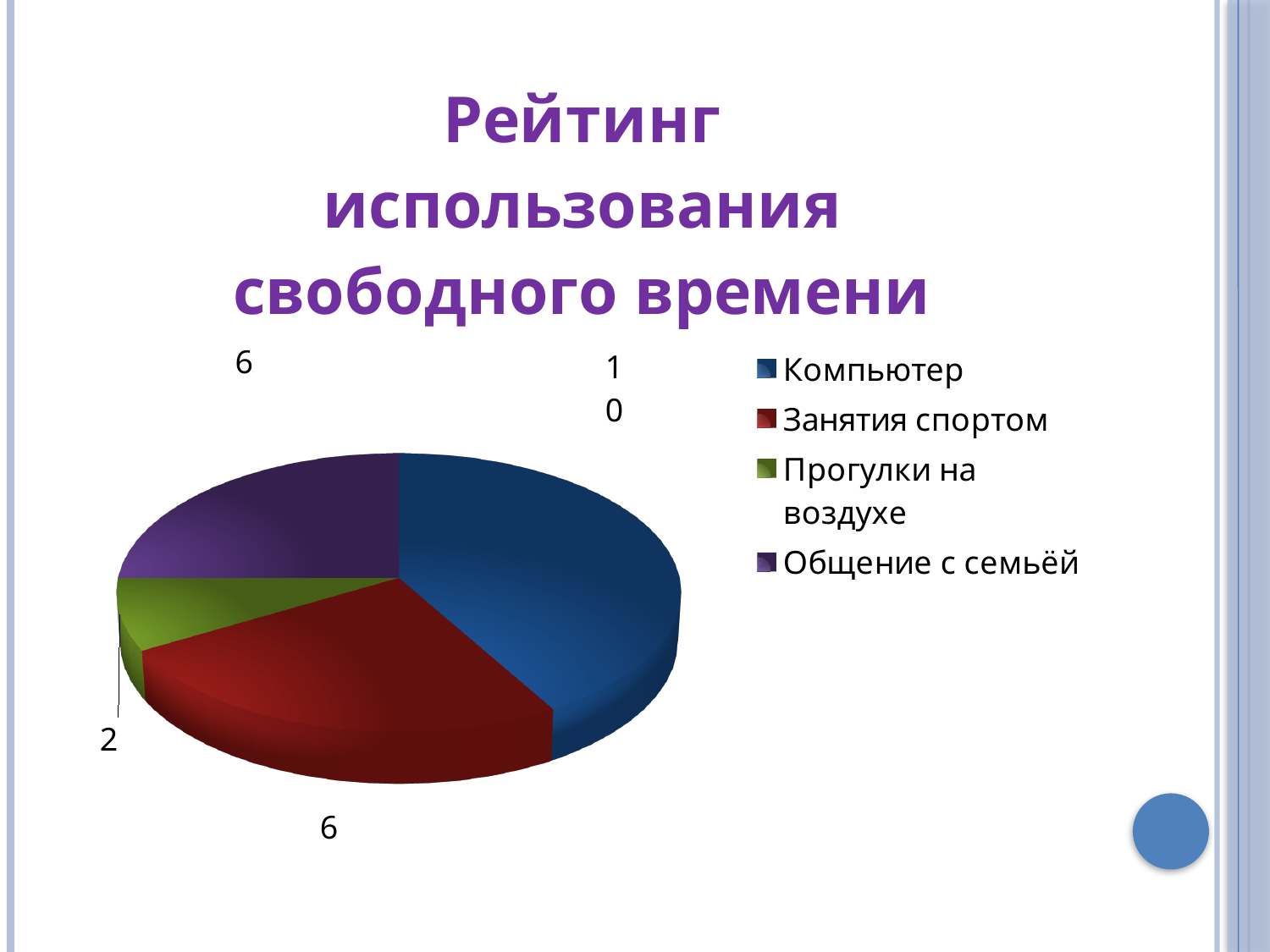
How many categories does the legend list? 4 What type of chart is shown on the slide? pie chart Which is larger, the value for Компьютер or the value for Занятия спортом? Компьютер Which category has the smallest slice? Прогулки на воздухе What is the value for Прогулки на воздухе? 2 What is the value for Общение с семьёй? 6 What is the title of the chart? Рейтинг использования свободного времени What is the value for Занятия спортом? 6 What is the difference between the values for Компьютер and Прогулки на воздухе? 8 What share of the pie does Занятия спортом represent? 25% What is the value for Компьютер? 10 Which category has the largest slice? Компьютер